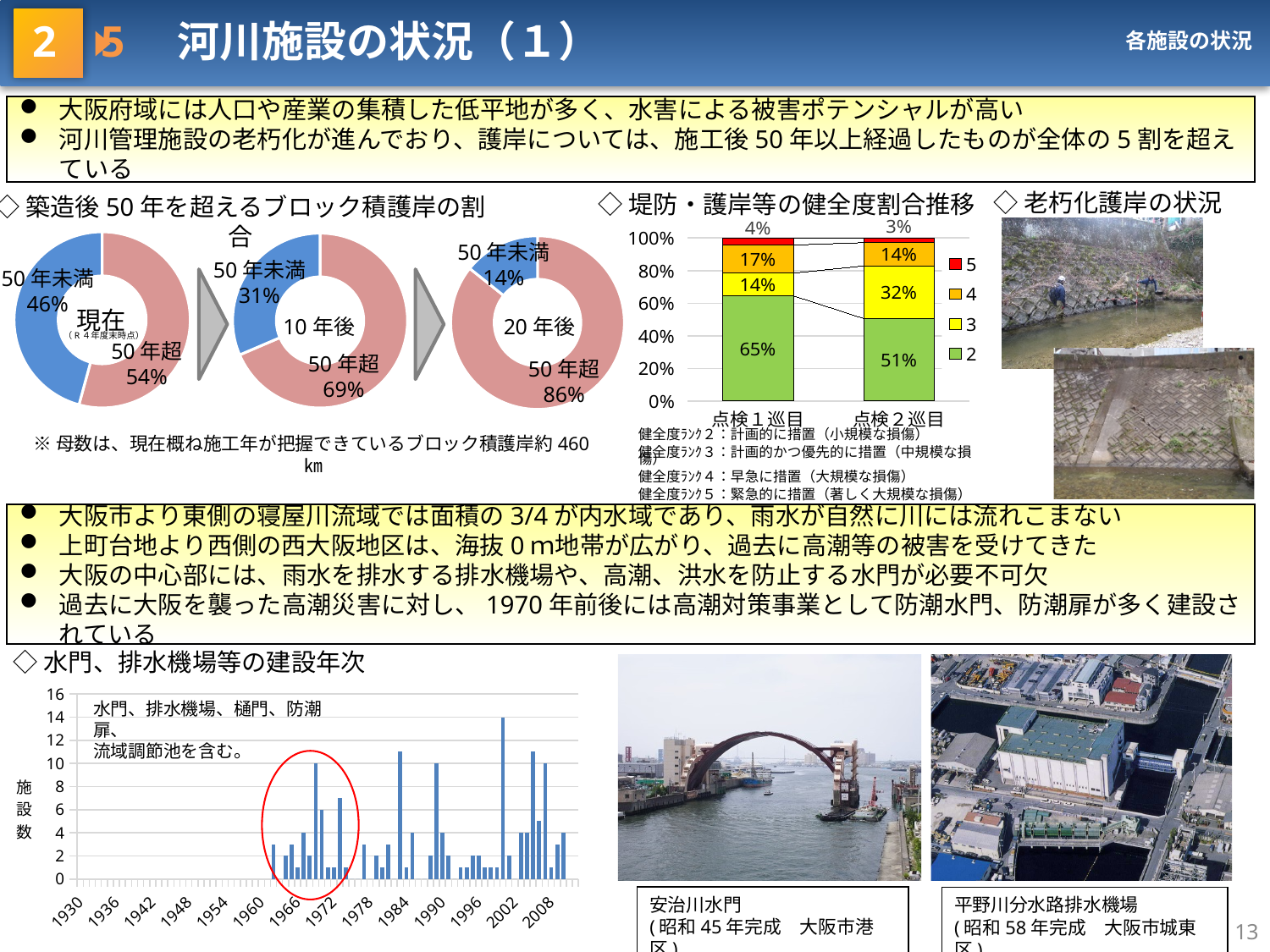
Across the three donut charts (現在, 10年後, 20年後), does the share of 50年超 rise or fall over time? rise In the 堤防・護岸等の健全度割合推移 chart, how many series does the legend list? 4 In the donut chart for 現在 (築造後50年を超えるブロック積護岸の割合), what percentage is 50年超? 54% In the 堤防・護岸等の健全度割合推移 chart, which inspection round has the larger value for 健全度ランク4, 点検1巡目 or 点検2巡目? 点検1巡目 In the 堤防・護岸等の健全度割合推移 chart, what is the value for 健全度ランク2 in 点検1巡目? 65% In the donut chart for 20年後 (築造後50年を超えるブロック積護岸の割合), what percentage is 50年未満? 14% What kind of chart is 水門、排水機場等の建設年次? bar chart In the 堤防・護岸等の健全度割合推移 chart, what is the value for 健全度ランク3 in 点検2巡目? 32% In the 水門、排水機場等の建設年次 chart, is the tallest bar (around 2001) greater or less than 12? greater In the 堤防・護岸等の健全度割合推移 chart, what is the value for 健全度ランク5 in 点検1巡目? 4% In the donut chart for 10年後 (築造後50年を超えるブロック積護岸の割合), what percentage is 50年超? 69% In the 堤防・護岸等の健全度割合推移 chart, what is the difference between the 健全度ランク2 values for 点検1巡目 and 点検2巡目? 14%